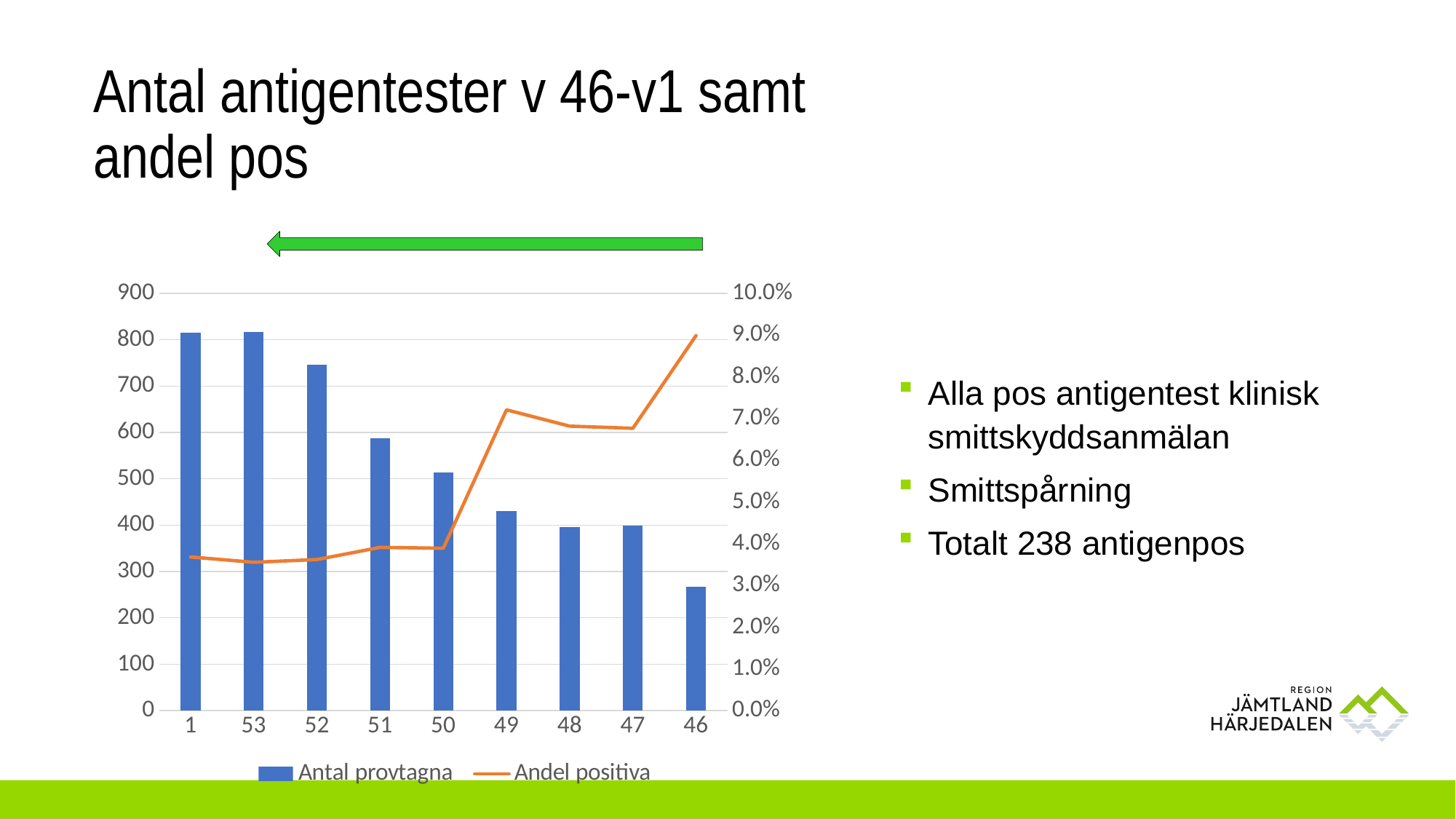
Which week has the lowest value for Antal provtagna? 46 Do the Antal provtagna bars rise or fall from left to right along the x axis? fall What kind of chart is shown on the slide? A combined bar and line chart Is the Antal provtagna value for week 52 greater or less than 700? greater Which week has the larger Antal provtagna value, week 51 or week 49? 51 Which week has the highest value for Andel positiva? 46 Is the Antal provtagna value for week 46 greater or less than 300? less How many series does the legend list? 2 What are the two series named in the legend? Antal provtagna and Andel positiva How many weeks (categories) are shown on the x axis? 9 Is the Andel positiva value for week 1 greater or less than 4.0%? less